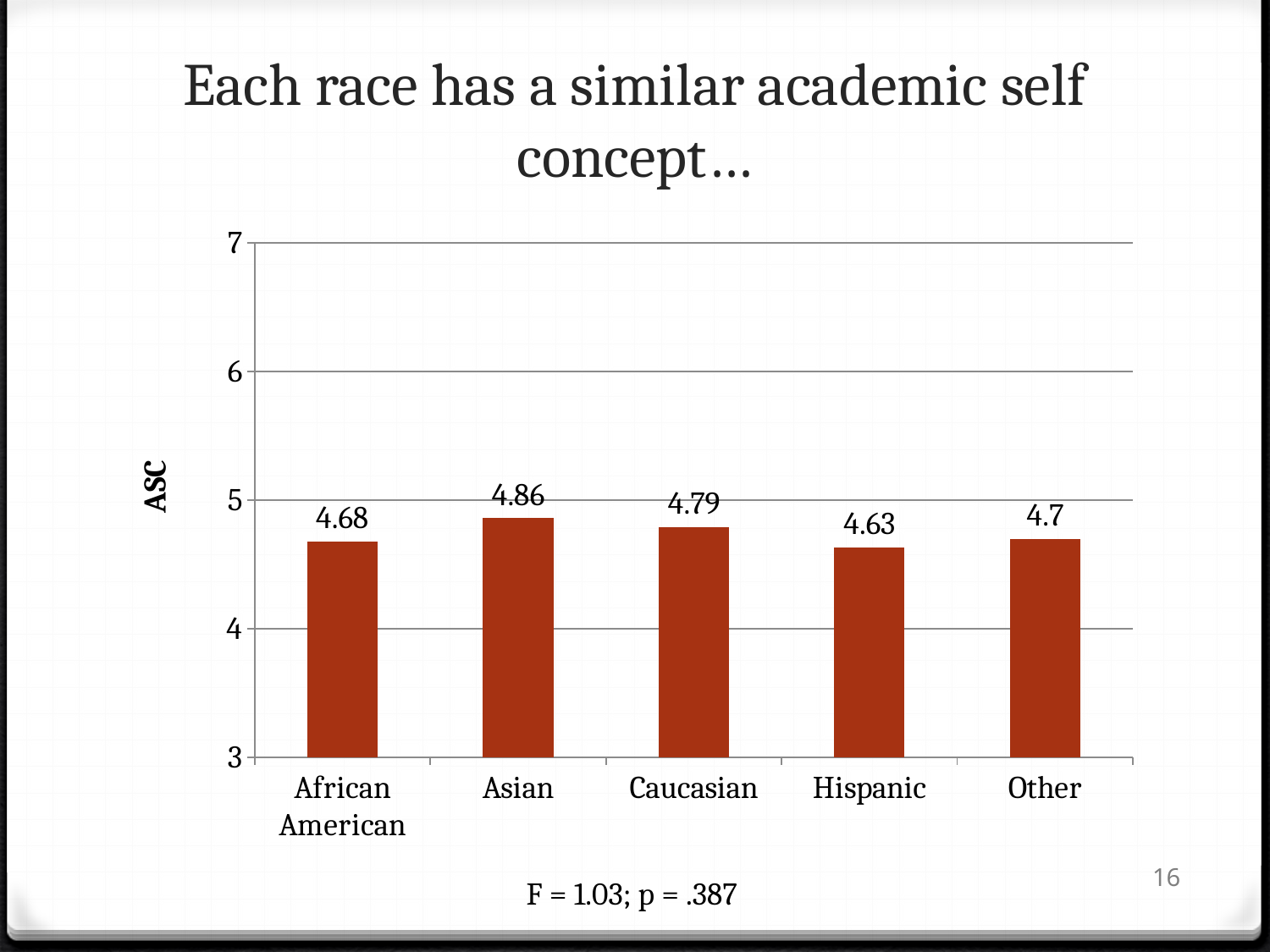
What is the difference between the ASC values for Asian and Hispanic? 0.23 How many race categories are shown in the chart? 5 Which race has the lowest ASC value? Hispanic Which has a larger ASC value, Caucasian or Other? Caucasian What is the ASC value for Asian? 4.86 What is the difference between the ASC values for Caucasian and African American? 0.11 What is the ASC value for Other? 4.7 What is the ASC value for African American? 4.68 What kind of chart is shown on the slide? bar chart Is the ASC value for Asian greater or less than 5? less What is the ASC value for Hispanic? 4.63 Which race has the highest ASC value? Asian